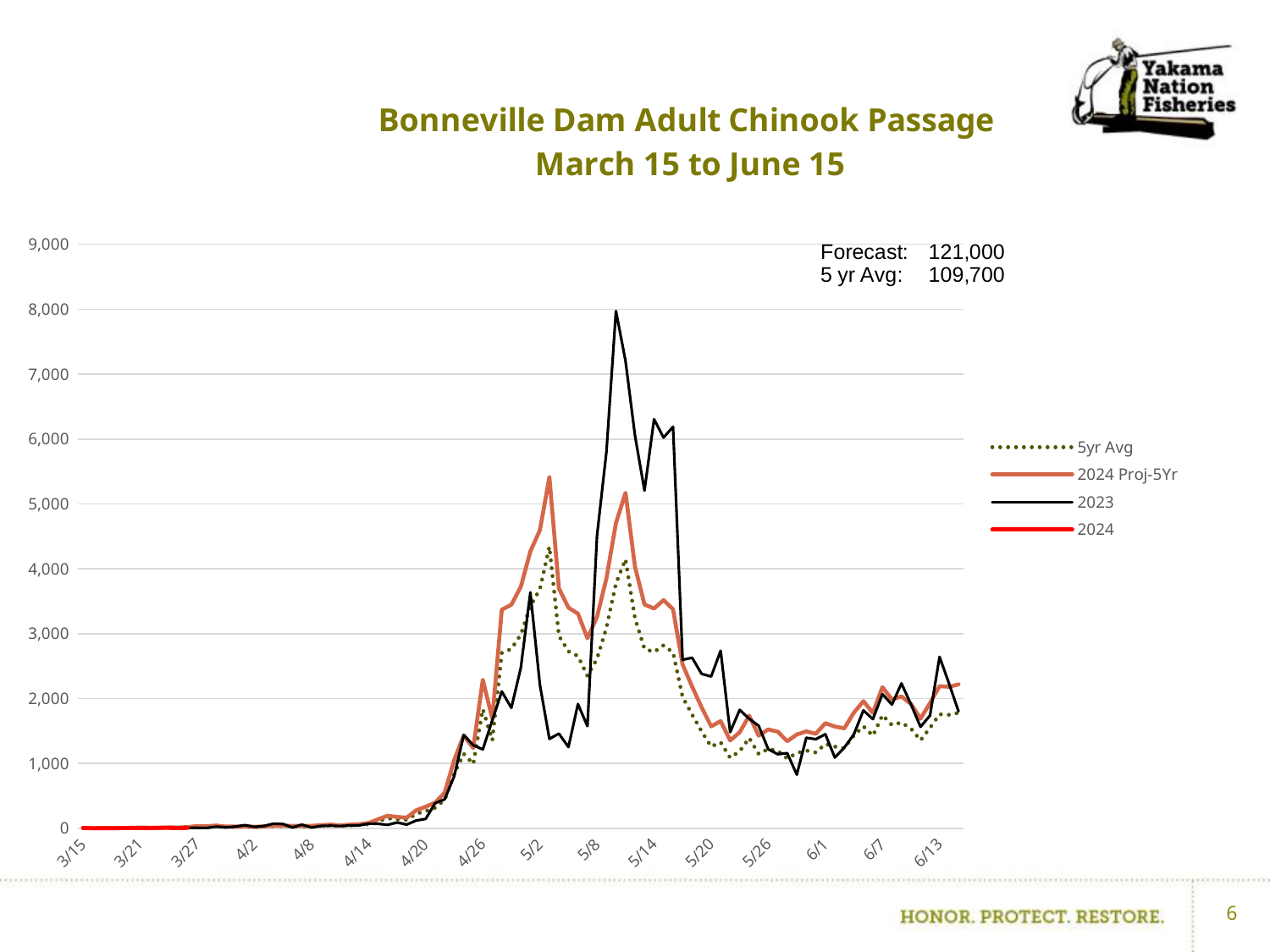
What 5 yr Avg value is printed in the text annotation on the chart? 109,700 Is the peak value of the 2023 series greater or less than 7,000? greater What kind of chart is shown on the slide? line chart Which series reaches the highest value on the chart? 2023 Does the 2023 series rise or fall between about 5/10 and 5/20? fall Is the highest value of the 5yr Avg series greater or less than 5,000? less What forecast value is printed on the chart? 121,000 What is the title of the chart? Bonneville Dam Adult Chinook Passage March 15 to June 15 How many series does the legend list? 4 Is the highest value of the 2024 Proj-5Yr series greater or less than 5,000? greater Which is larger, the peak of the 2023 series or the peak of the 2024 Proj-5Yr series? 2023 Which series is drawn as a dotted line in the legend? 5yr Avg